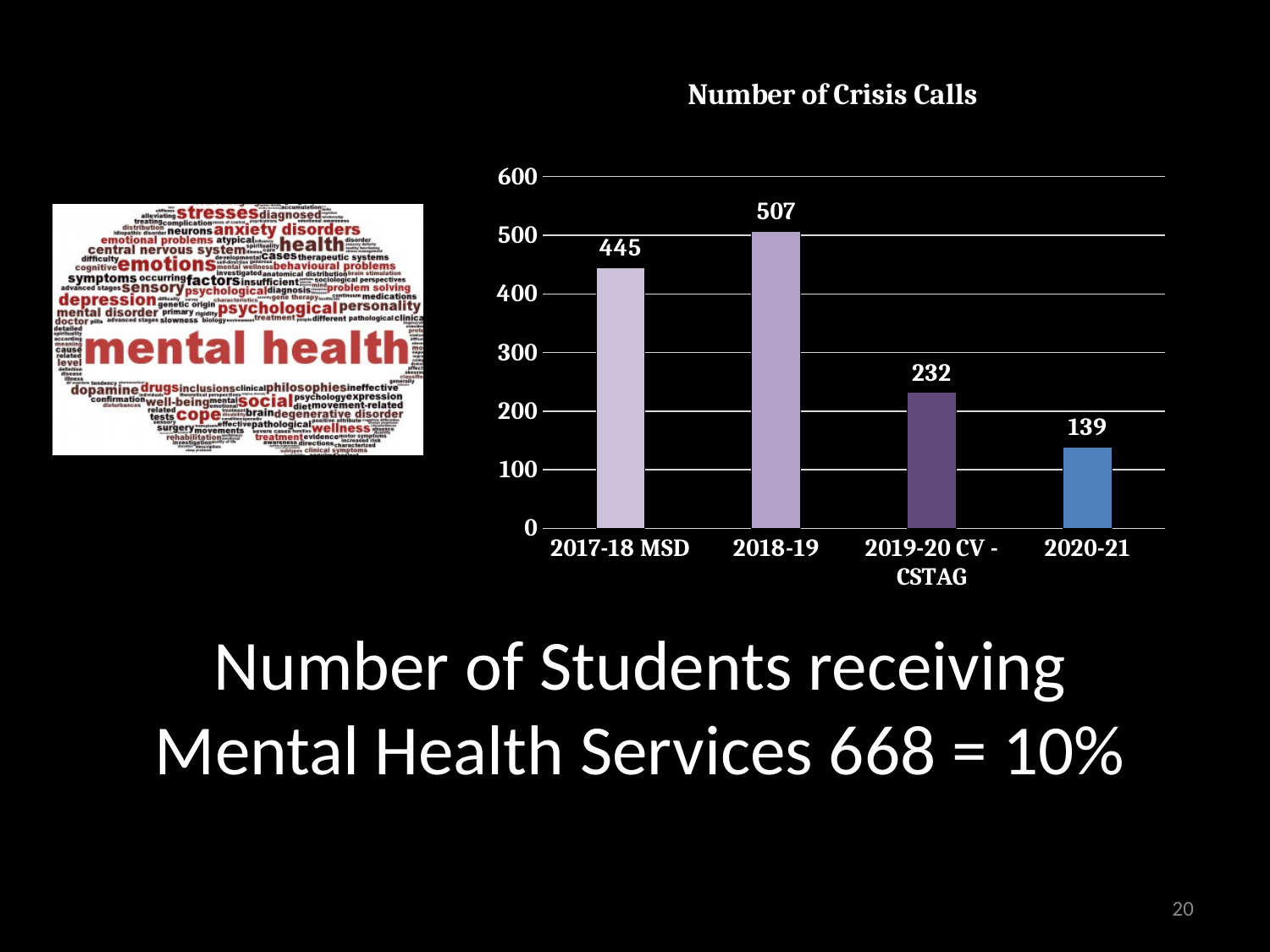
What is the number of crisis calls for 2017-18 MSD? 445 Which had more crisis calls, 2017-18 MSD or 2019-20 CV - CSTAG? 2017-18 MSD What is the number of crisis calls for 2018-19? 507 Which year had the highest number of crisis calls? 2018-19 What is the number of crisis calls for 2019-20 CV - CSTAG? 232 Which year had the lowest number of crisis calls? 2020-21 Is the value for 2018-19 greater or less than 500? greater What is the number of crisis calls for 2020-21? 139 What kind of chart is shown on the slide? bar chart How many categories are shown on the x axis of the chart? 4 What is the difference in crisis calls between 2018-19 and 2020-21? 368 What is the title of the chart? Number of Crisis Calls